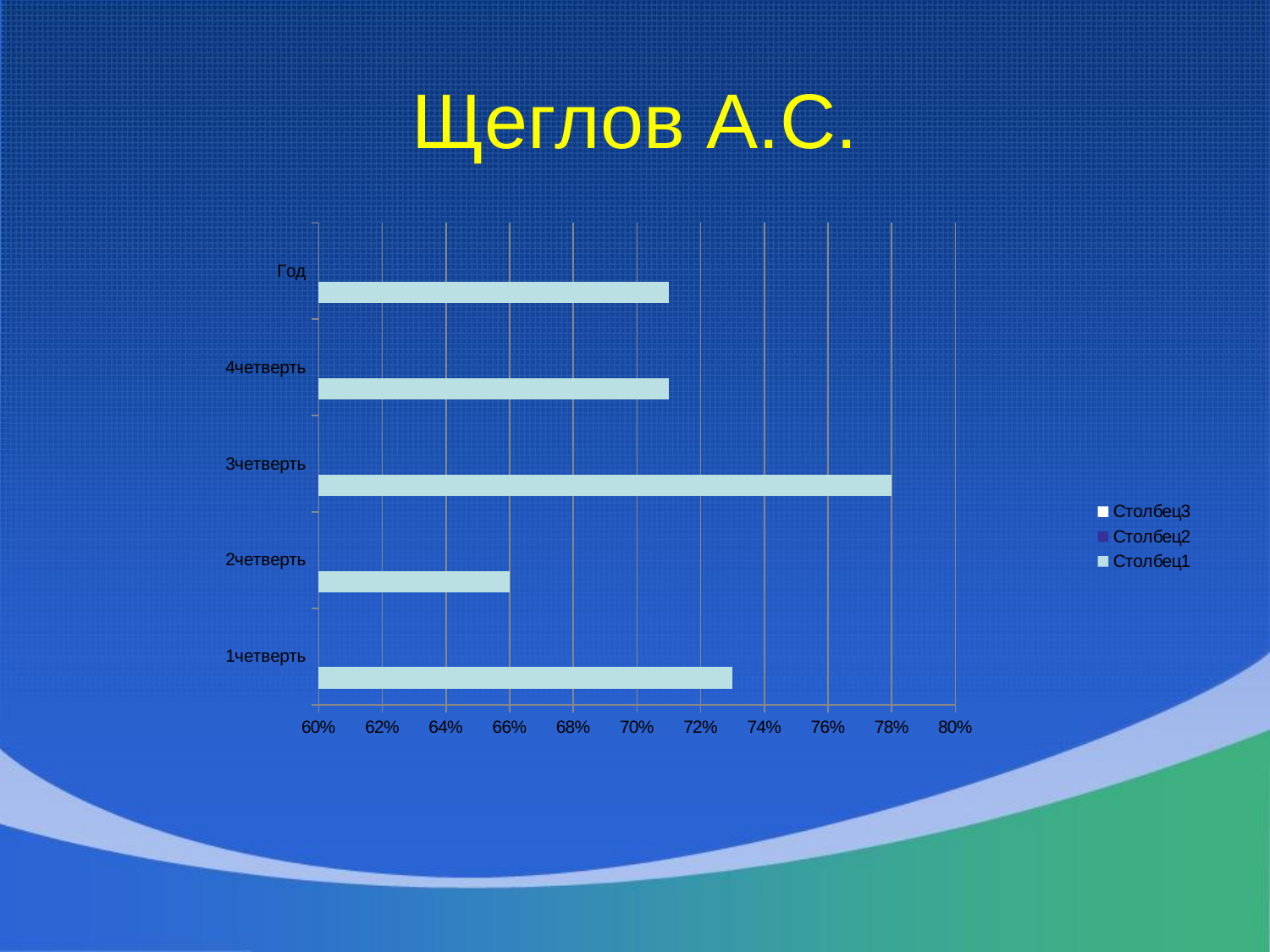
Is the value for 1четверть greater or less than 72%? greater How many series does the legend list? 3 What kind of chart is shown on the slide? bar chart What is the difference between the values for 3четверть and 2четверть? 12% How many categories are plotted on the chart? 5 Which has a larger value, 1четверть or 4четверть? 1четверть Is the value for 4четверть greater or less than 70%? greater What is the value for 2четверть? 66% Which category has the highest value? 3четверть What is the title of the slide above the chart? Щеглов А.С. What is the value for 3четверть? 78% Which category has the lowest value? 2четверть